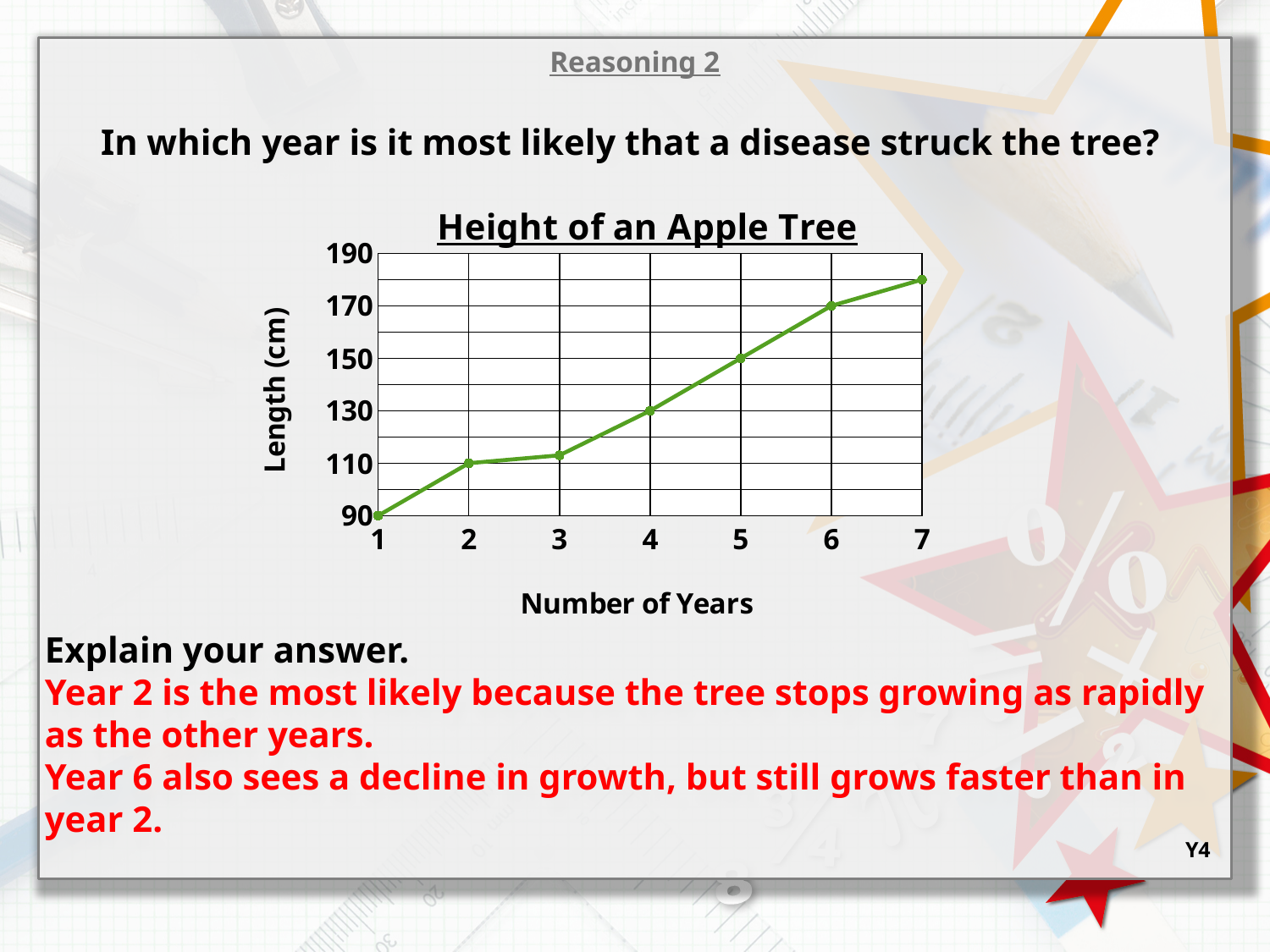
In which year is the tree's height the greatest? 7 What is the height of the apple tree at year 1? 90 What is the height of the apple tree at year 4? 130 What is the height of the apple tree at year 2? 110 In which year is the tree's height the lowest? 1 How many years are plotted on the chart? 7 What is the height of the apple tree at year 6? 170 Does the height of the tree rise or fall as the number of years increases? rise How much taller is the tree at year 6 than at year 4? 40 Which is larger, the height at year 5 or the height at year 2? year 5 What kind of chart is shown? line chart Is the height at year 7 greater or less than 170? greater